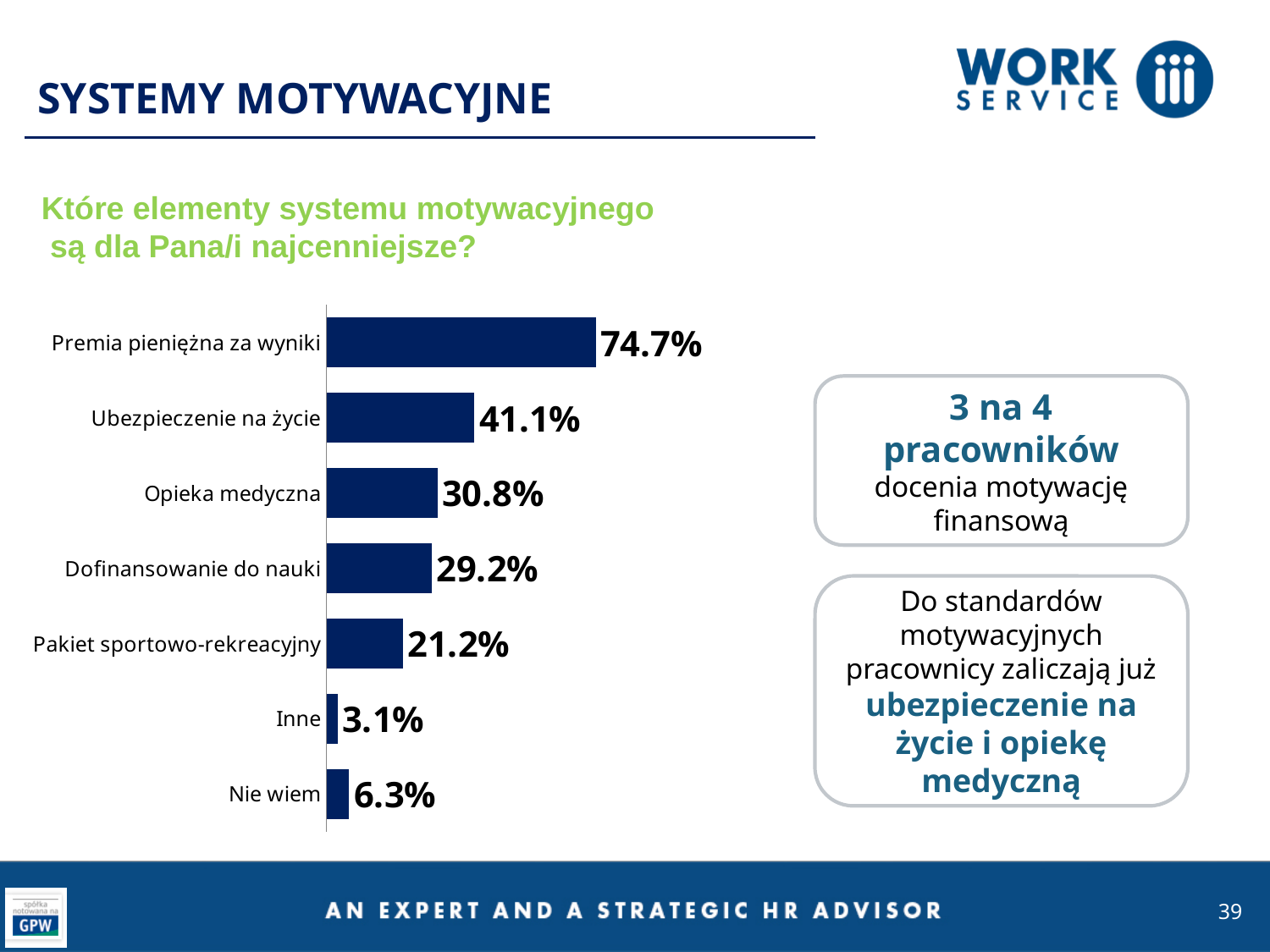
What is the value for "Ubezpieczenie na życie"? 41.1% What is the difference between the values for "Premia pieniężna za wyniki" and "Ubezpieczenie na życie"? 33.6% What question does the chart answer, as stated in the green heading above it? Które elementy systemu motywacyjnego są dla Pana/i najcenniejsze? Which category has the highest value? Premia pieniężna za wyniki What kind of chart is shown on the slide? Bar chart What is the difference between the values for "Nie wiem" and "Inne"? 3.2% What is the value for "Premia pieniężna za wyniki"? 74.7% Which category has the lowest value? Inne How many categories are shown in the chart? 7 Which is larger, the value for "Opieka medyczna" or "Dofinansowanie do nauki"? Opieka medyczna What is the value for "Pakiet sportowo-rekreacyjny"? 21.2% What is the value for "Opieka medyczna"? 30.8%